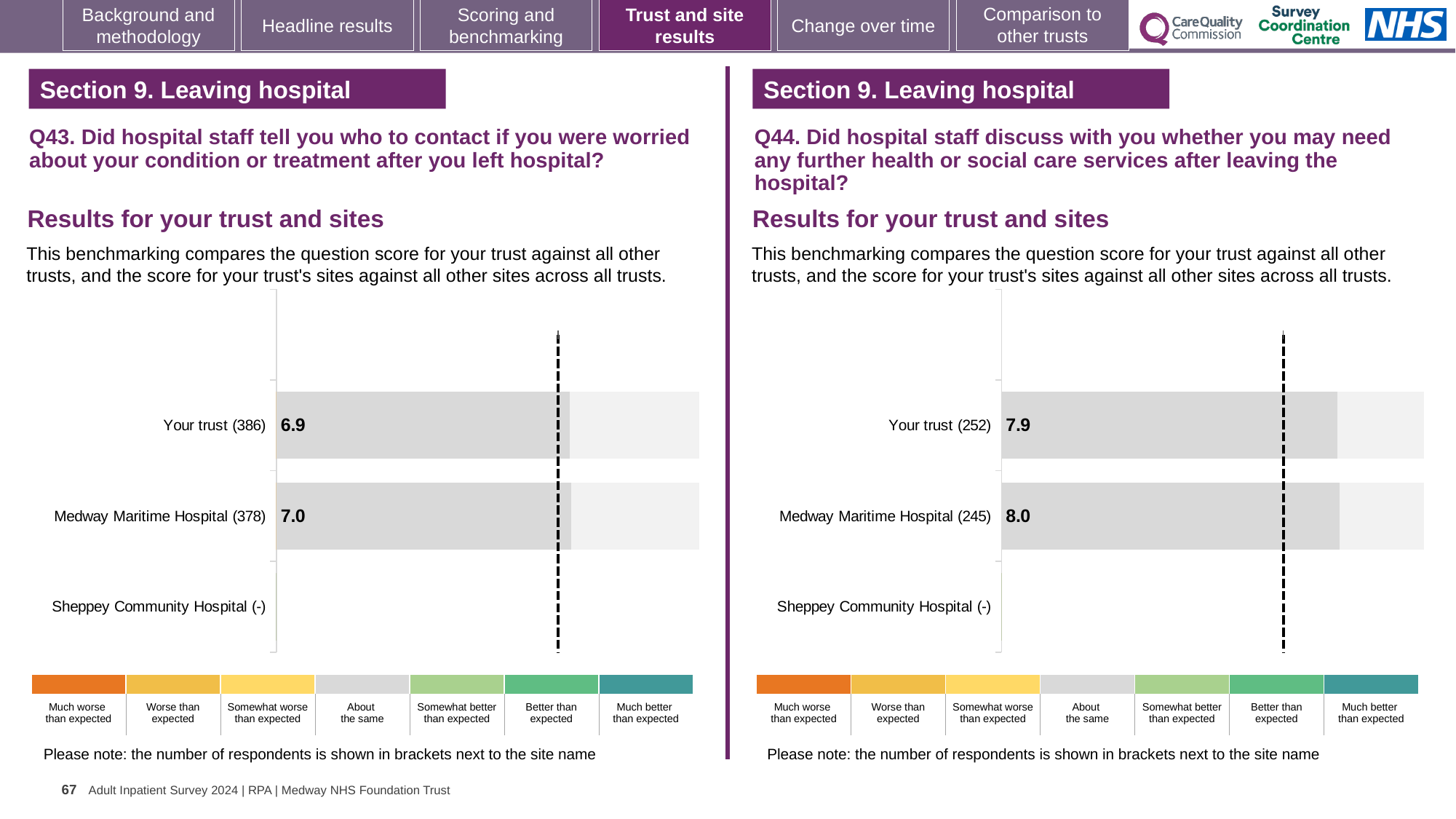
In the Q43 chart (left), how many site/trust categories are listed on the vertical axis? 3 How many categories does the colour key below each chart list? 7 In the Q44 chart (right), which category has no score shown? Sheppey Community Hospital In the Q43 chart (left), how many respondents are shown in brackets for Your trust? 386 In the Q44 chart (right), what is the difference between the Medway Maritime Hospital score and the Your trust score? 0.1 In the Q43 chart (left), what is the score for Your trust? 6.9 In the Q44 chart (right), what is the score for Medway Maritime Hospital? 8.0 In the Q44 chart (right), what is the score for Your trust? 7.9 In the Q43 chart (left), what is the score for Medway Maritime Hospital? 7.0 In the Q44 chart (right), how many respondents are shown in brackets for Medway Maritime Hospital? 245 In the Q43 chart (left), what is the difference between the Medway Maritime Hospital score and the Your trust score? 0.1 What kind of chart is used on the left side of the slide for Q43? Bar chart